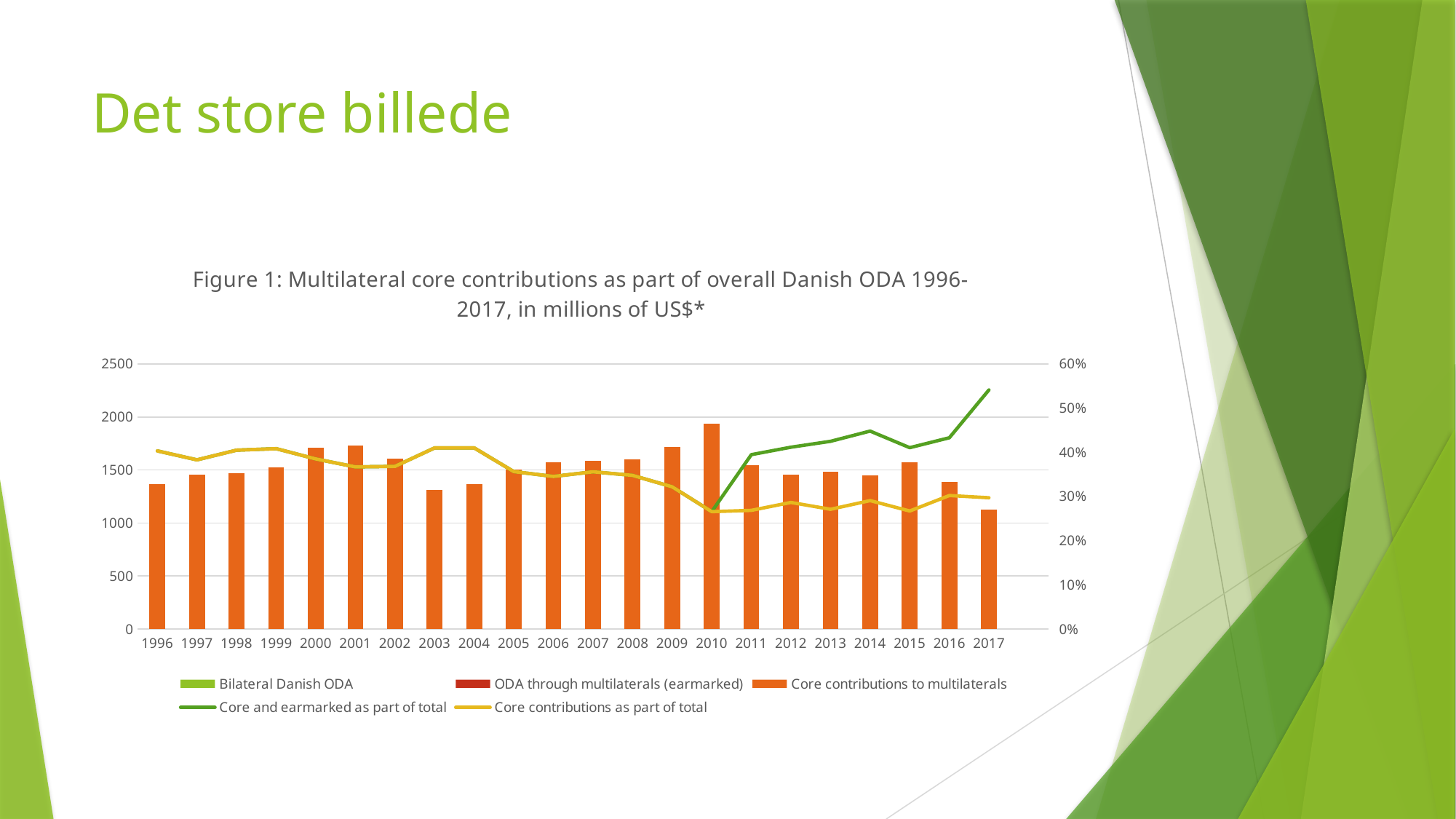
In which year is the bar for Core contributions to multilaterals highest? 2010 What kind of chart is shown on the slide? A combination chart of bars and lines Which series is drawn as a yellow line in the chart? Core contributions as part of total Which year has the larger bar for Core contributions to multilaterals, 2010 or 2017? 2010 How many series does the chart's legend list? 5 Does the Core and earmarked as part of total line rise or fall from 2010 to 2017? rise In which year is the bar for Core contributions to multilaterals lowest? 2017 Is the bar for Core contributions to multilaterals in 2010 greater or less than 1500? greater Is the value of the Core and earmarked as part of total line in 2017 greater or less than 50%? greater What is the title of the chart? Figure 1: Multilateral core contributions as part of overall Danish ODA 1996-2017, in millions of US$* How many years are shown on the x axis of the chart? 22 Is the bar for Core contributions to multilaterals in 2003 greater or less than 1500? less